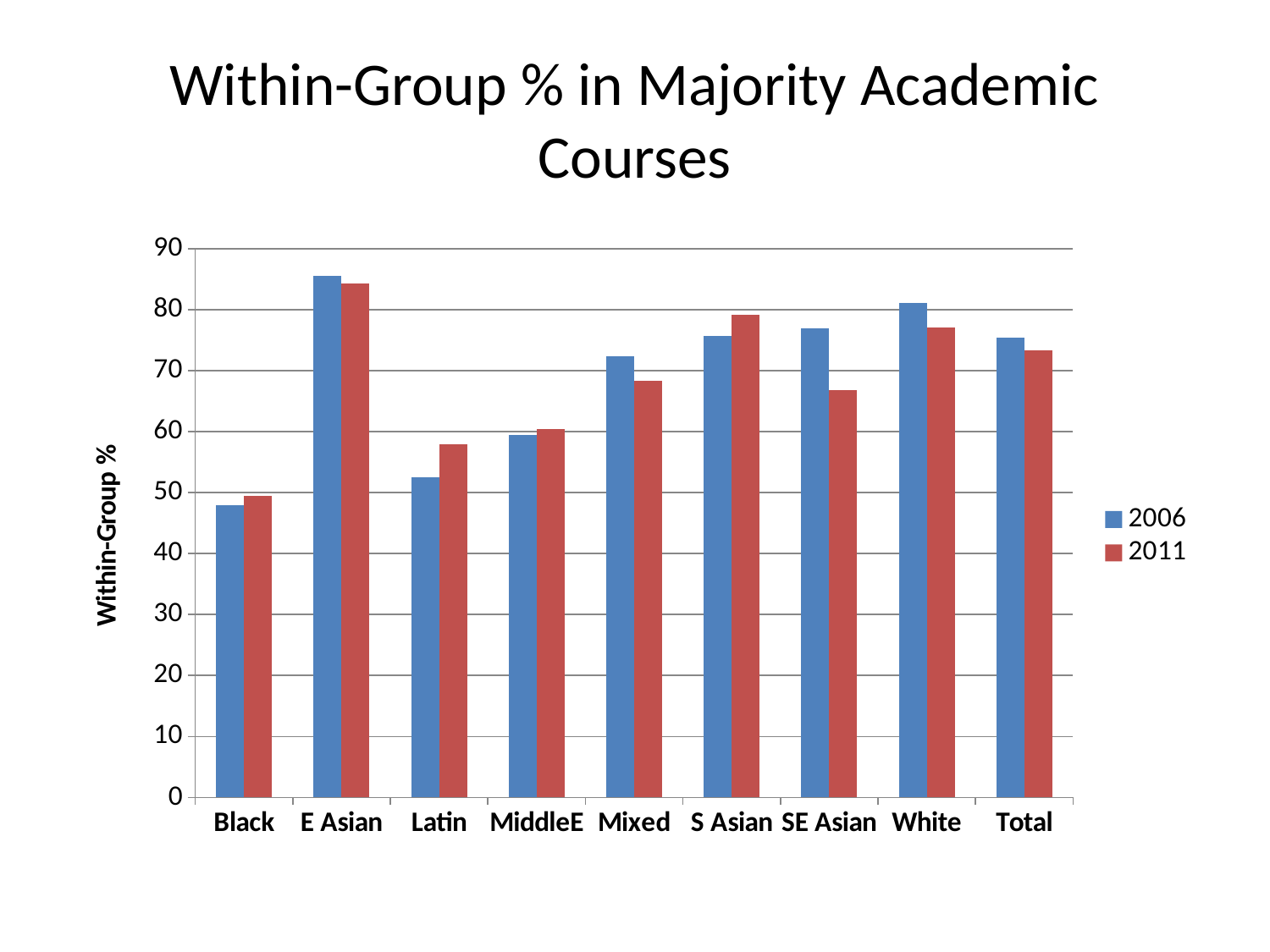
What kind of chart is shown on the slide? bar chart Is the 2011 value for SE Asian greater or less than 60? greater How many series does the legend list? 2 What is the label of the y axis? Within-Group % How many categories are shown on the x axis? 9 For SE Asian, which is larger: the 2006 value or the 2011 value? 2006 What colour are the bars for the 2011 series? red For Latin, which is larger: the 2006 value or the 2011 value? 2011 Is the 2006 value for Black greater or less than 50? less Which category has the highest value for 2006? E Asian Which category has the lowest value for 2011? Black Is the 2006 value for E Asian greater or less than 80? greater